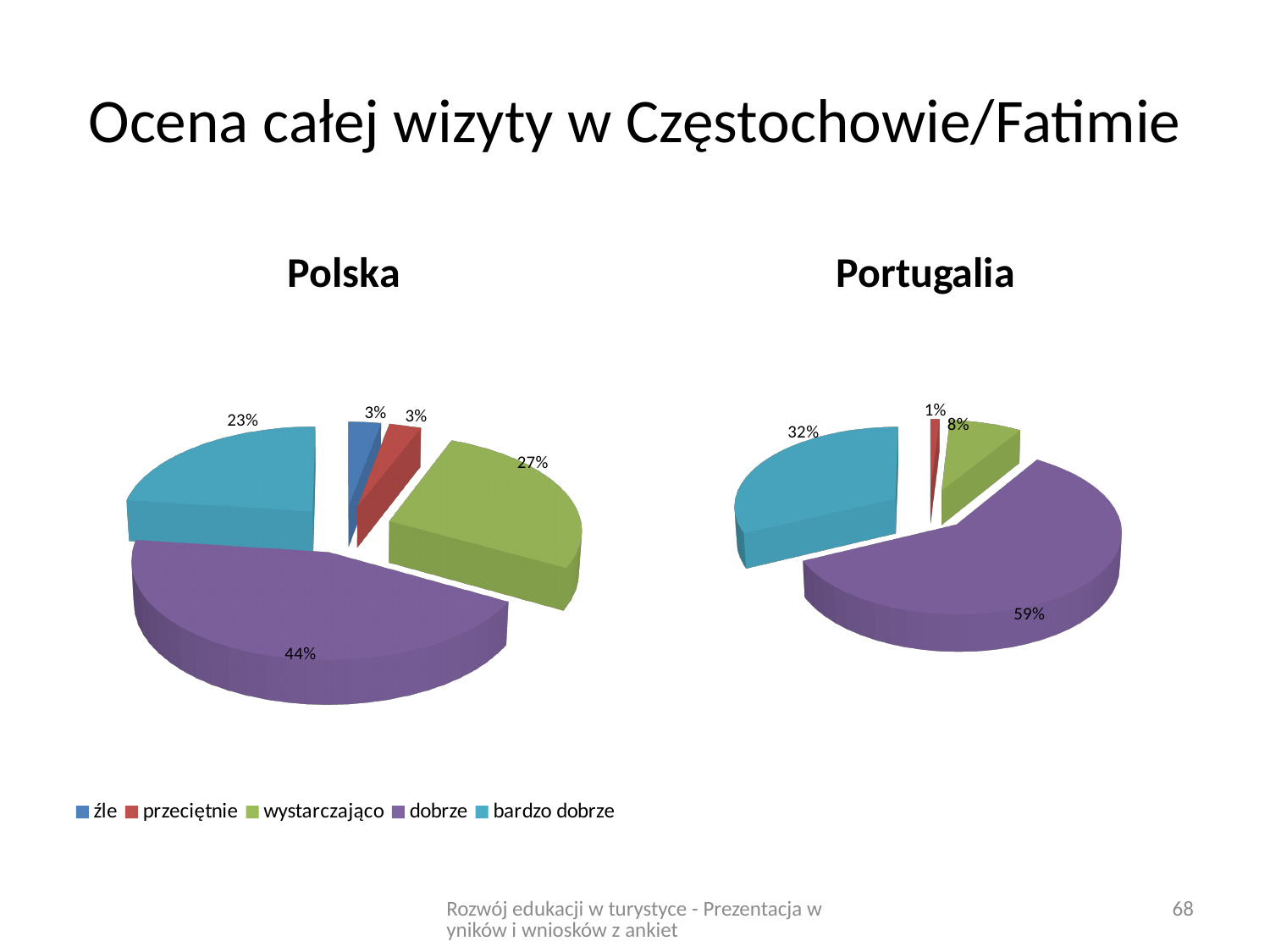
In the Portugalia pie chart, what share is labelled for the 'bardzo dobrze' slice? 32% In the Polska pie chart, what share is labelled for the 'dobrze' slice? 44% What is the difference between the 'dobrze' share in the Portugalia chart and the 'dobrze' share in the Polska chart? 15% How many categories does the legend list? 5 In the Portugalia pie chart, which category has the largest slice? dobrze In the Polska pie chart, which category has the largest slice? dobrze In the Portugalia pie chart, what share is labelled for the 'przeciętnie' slice? 1% In the Portugalia pie chart, which labelled category has the smallest slice? przeciętnie How many slices are shown in the Polska pie chart? 5 What type of chart is used for Polska and Portugalia on this slide? Pie chart In the Polska pie chart, what share is labelled for the 'wystarczająco' slice? 27% Which chart shows a larger share for 'bardzo dobrze', Polska or Portugalia? Portugalia